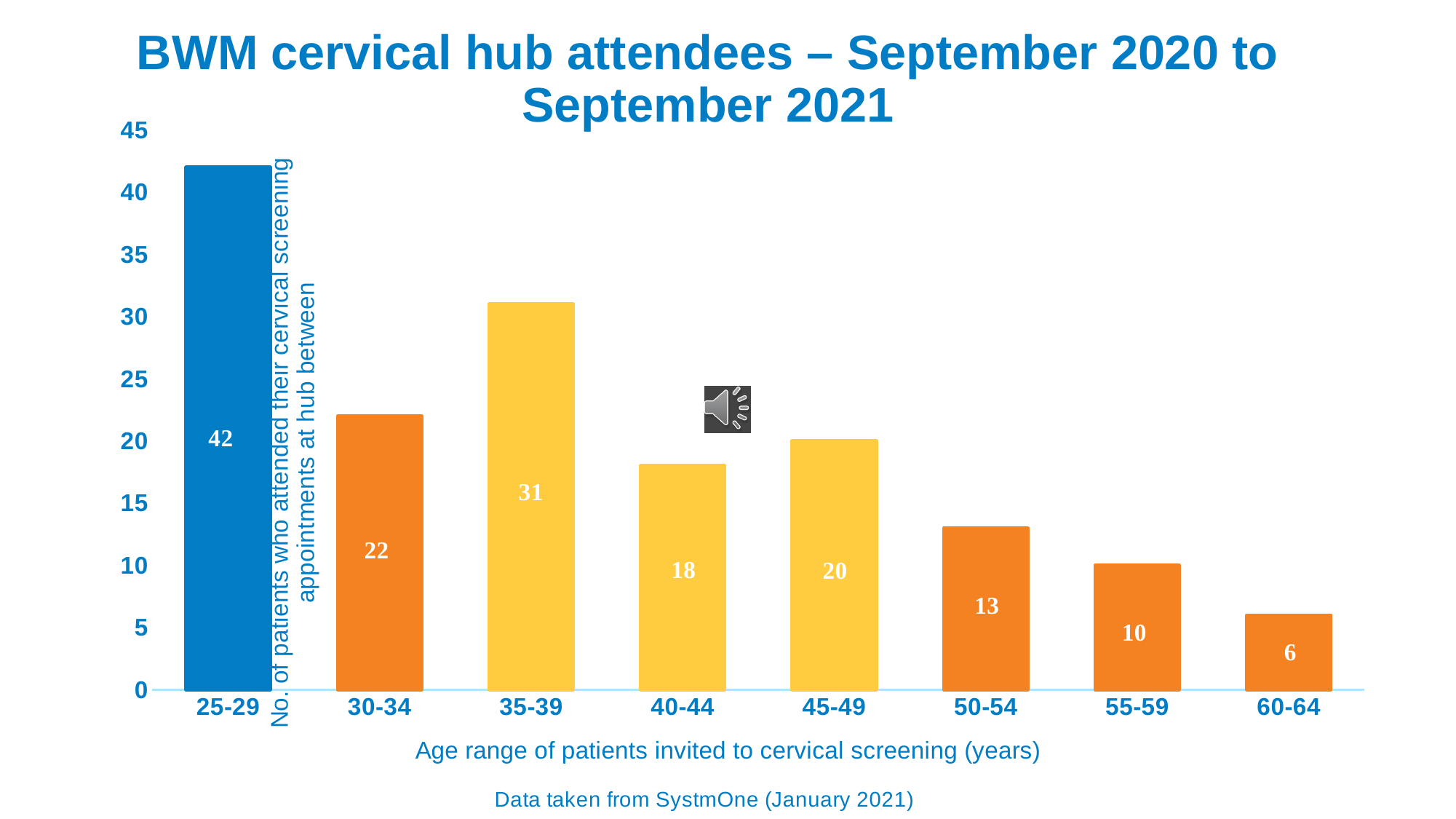
What is the title of the chart? BWM cervical hub attendees – September 2020 to September 2021 What is the value shown for the 45-49 age range? 20 What is the difference between the number of attendees aged 30-34 and those aged 50-54? 9 Which age range has more attendees, 40-44 or 45-49? 45-49 What is the difference between the number of attendees aged 25-29 and those aged 35-39? 11 How many patients aged 25-29 attended their cervical screening appointments at the hub? 42 What is the value shown for the 55-59 age range? 10 How many age ranges are shown on the x axis? 8 Which age range has the highest number of attendees? 25-29 Which age range has the lowest number of attendees? 60-64 Is the value for the 35-39 age range greater or less than 30? greater What kind of chart is shown on the slide? Bar chart